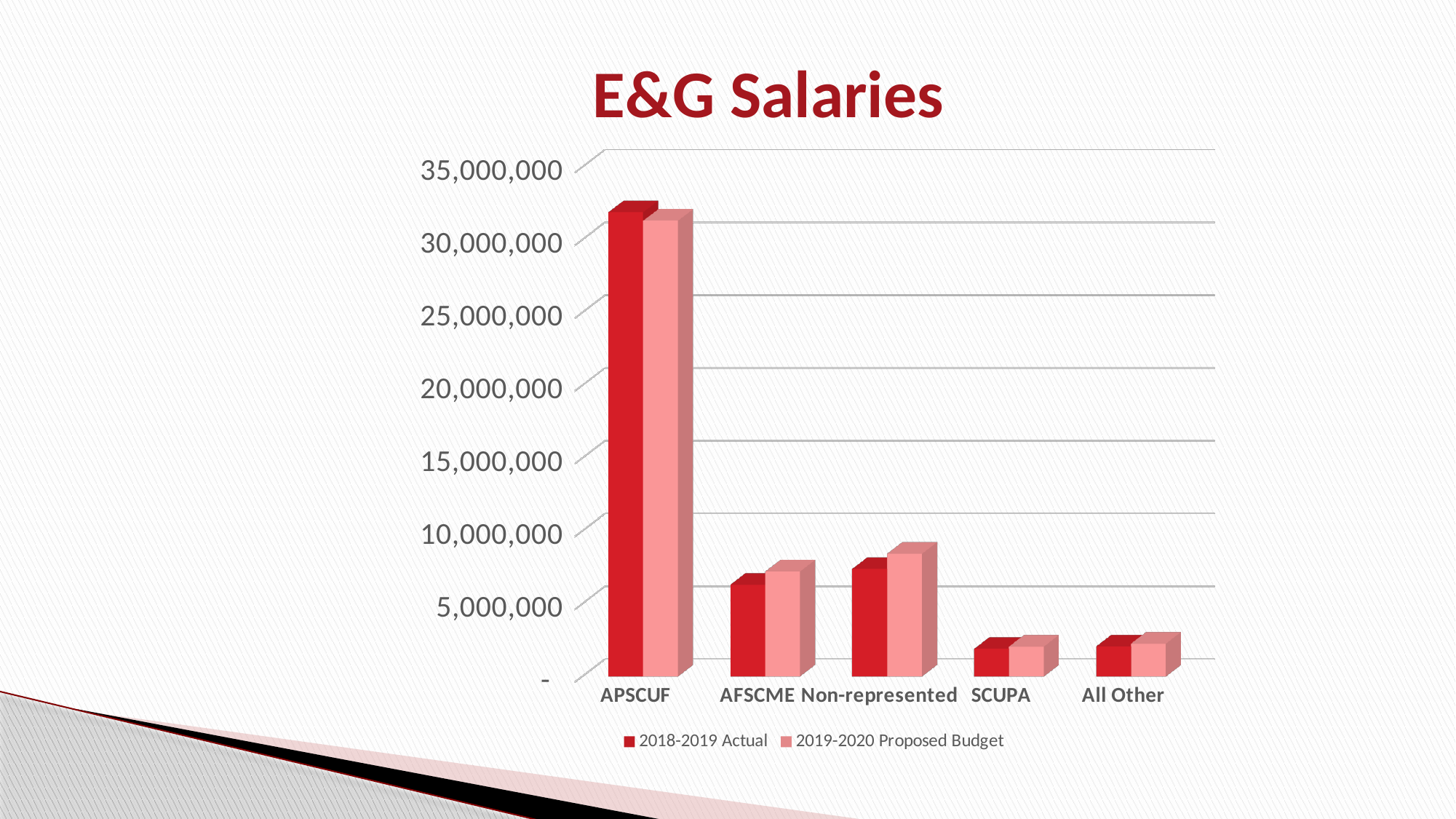
Which category has the highest 2018-2019 Actual salaries? APSCUF Which is larger for the 2019-2020 Proposed Budget: AFSCME or Non-represented? Non-represented Is the 2018-2019 Actual value for APSCUF greater or less than 25,000,000? greater Which category has the highest 2019-2020 Proposed Budget salaries? APSCUF How many categories are shown on the x axis of the chart? 5 Is the 2018-2019 Actual value for AFSCME greater or less than 10,000,000? less Is the 2019-2020 Proposed Budget value for Non-represented greater or less than 10,000,000? less What is the title of the chart? E&G Salaries How many series does the legend list? 2 What kind of chart is shown on the slide? bar chart What are the two series named in the legend? 2018-2019 Actual and 2019-2020 Proposed Budget